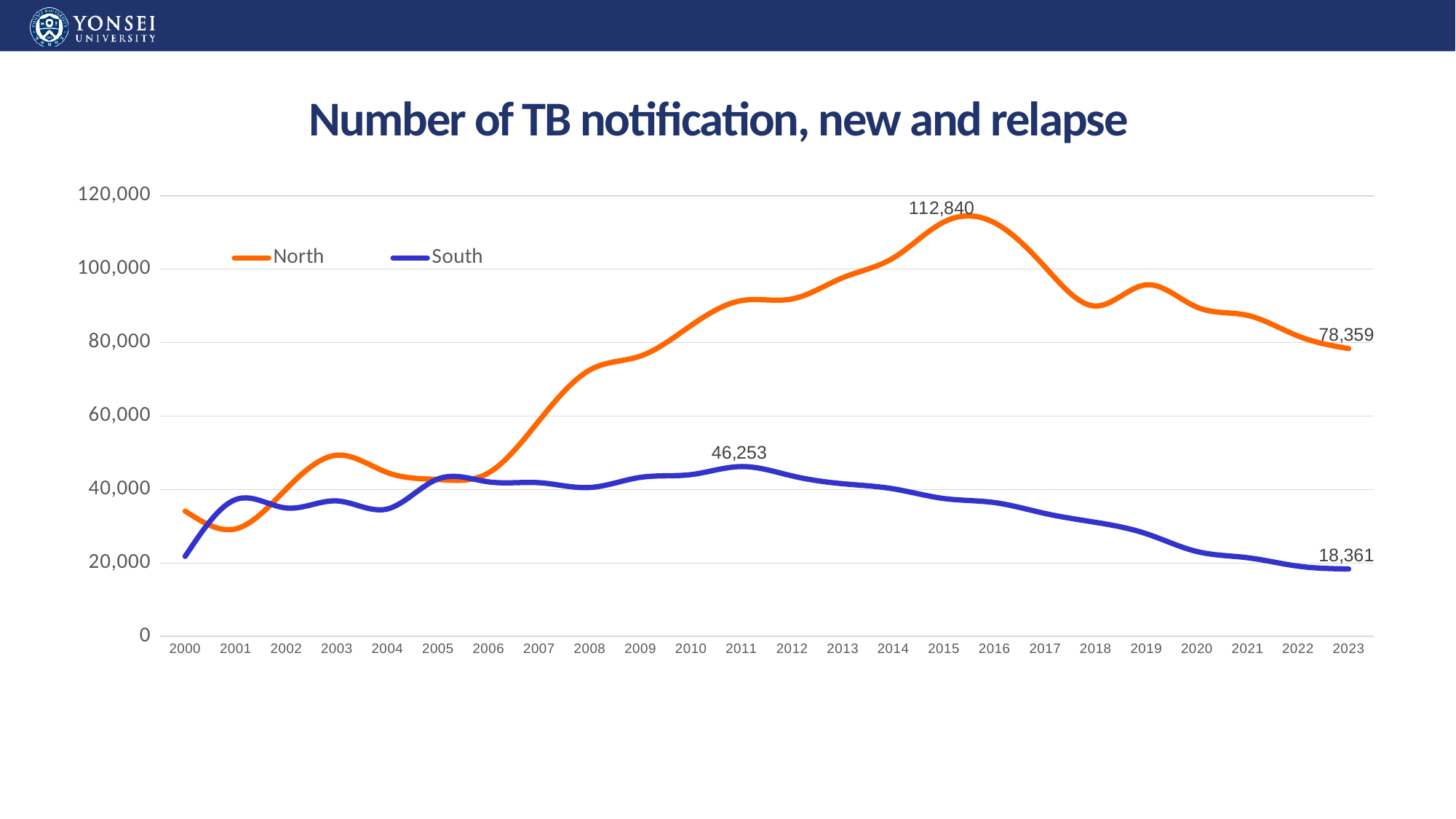
What is the value for South in 2023? 18,361 Is the value for North in 2010 greater or less than 80,000? greater What is the difference between the North and South values in 2023? 59,998 Does the South line rise or fall from 2011 to 2023? fall How many series does the legend list? 2 What is the peak value labelled on the North line? 112,840 Is the value for South in 2000 greater or less than 40,000? less Which series has the larger value in 2023, North or South? North In which year does the North line reach its highest value? 2015 In which year does the South line reach its highest value? 2011 What is the value for North in 2023? 78,359 What kind of chart is shown on the slide? line chart